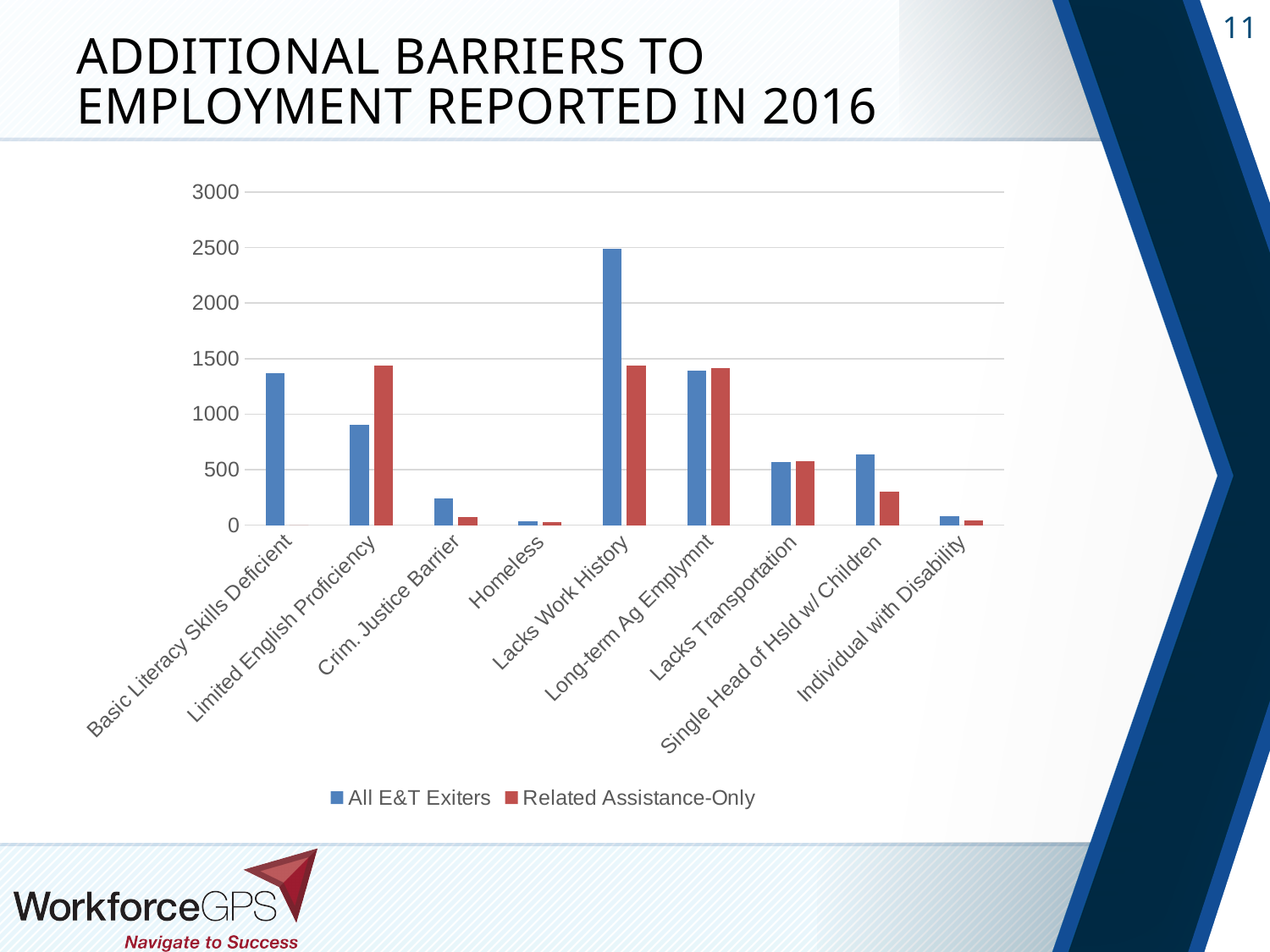
How many series does the legend list? 2 Is the All E&T Exiters value for Lacks Work History greater or less than 2000? greater For Limited English Proficiency, which series has the larger value: All E&T Exiters or Related Assistance-Only? Related Assistance-Only Is the All E&T Exiters value for Homeless greater or less than 500? less Which category has the lowest value for All E&T Exiters? Homeless Is the All E&T Exiters value for Basic Literacy Skills Deficient greater or less than 1000? greater For Single Head of Hsld w/ Children, which series has the larger value: All E&T Exiters or Related Assistance-Only? All E&T Exiters Which category has the highest value for All E&T Exiters? Lacks Work History What type of chart is shown on the slide? bar chart What is the title of the slide containing the chart? Additional Barriers to Employment Reported in 2016 How many barrier categories are shown on the x axis? 9